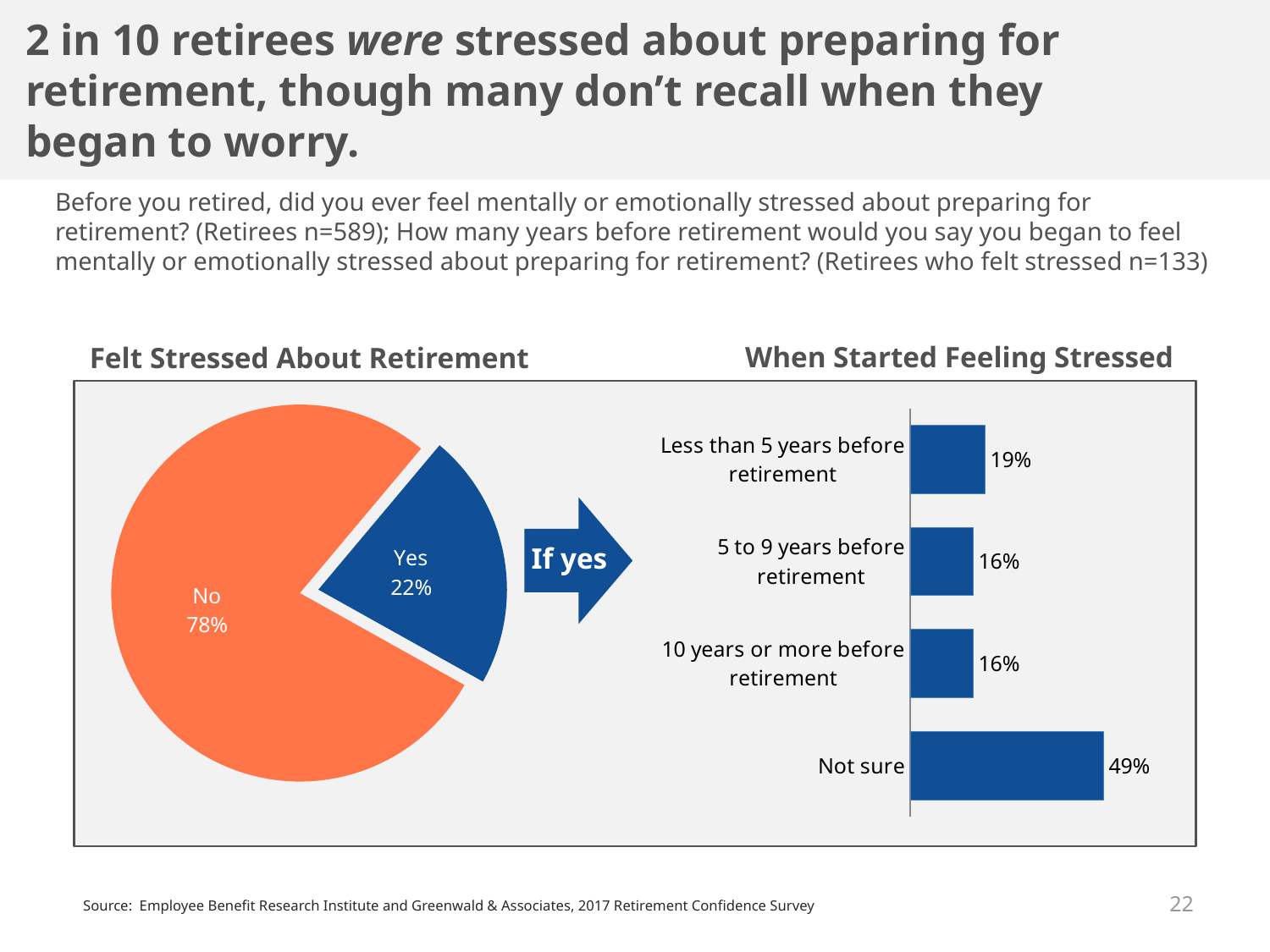
In the 'When Started Feeling Stressed' chart, what is the value for 'Not sure'? 49% In the 'Felt Stressed About Retirement' chart, which slice is larger, Yes or No? No In the 'When Started Feeling Stressed' chart, which category has the highest value? Not sure In the 'Felt Stressed About Retirement' chart, what is the difference between the No and Yes shares? 56% In the 'When Started Feeling Stressed' chart, how many categories are shown? 4 In the 'When Started Feeling Stressed' chart, what is the value for '5 to 9 years before retirement'? 16% In the 'When Started Feeling Stressed' chart, what is the value for 'Less than 5 years before retirement'? 19% In the 'Felt Stressed About Retirement' chart, what percentage of retirees answered Yes? 22% What kind of chart is 'When Started Feeling Stressed'? Bar chart In the 'Felt Stressed About Retirement' chart, what percentage of retirees answered No? 78% In the 'When Started Feeling Stressed' chart, what is the difference between 'Not sure' and 'Less than 5 years before retirement'? 30% What kind of chart is 'Felt Stressed About Retirement'? Pie chart